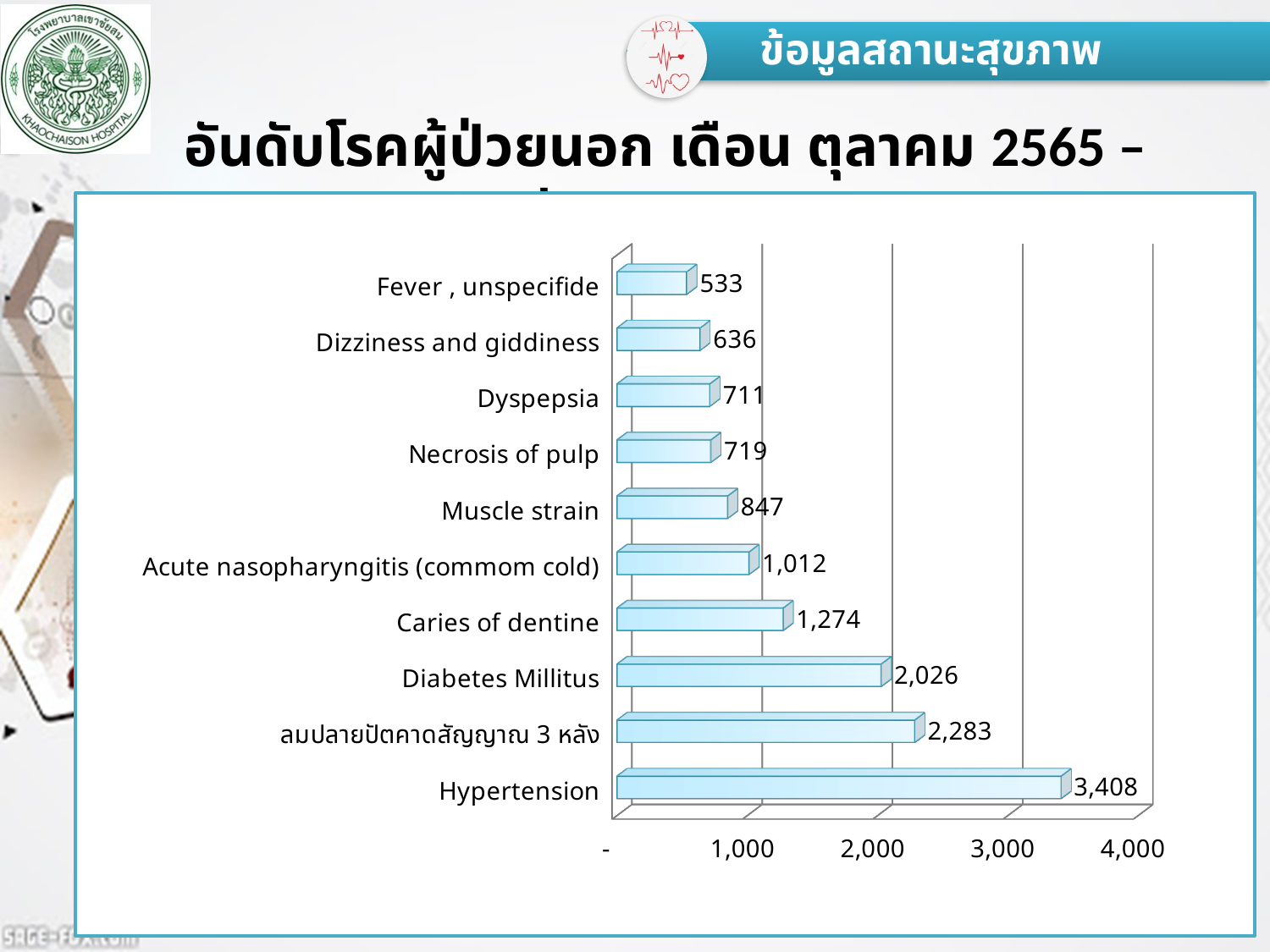
What is the value for Hypertension? 3,408 What is the value for Muscle strain? 847 What is the difference between the values for Hypertension and Diabetes Millitus? 1,382 Which category has the lowest value? Fever , unspecifide What is the value for Caries of dentine? 1,274 How many categories are shown in the chart? 10 Which is larger, the value for Acute nasopharyngitis (commom cold) or the value for Muscle strain? Acute nasopharyngitis (commom cold) Is the value for Caries of dentine greater or less than 1,000? greater What is the value for Diabetes Millitus? 2,026 What is the difference between the values for Dizziness and giddiness and Fever , unspecifide? 103 What kind of chart is shown on the slide? Bar chart Which category has the highest value? Hypertension